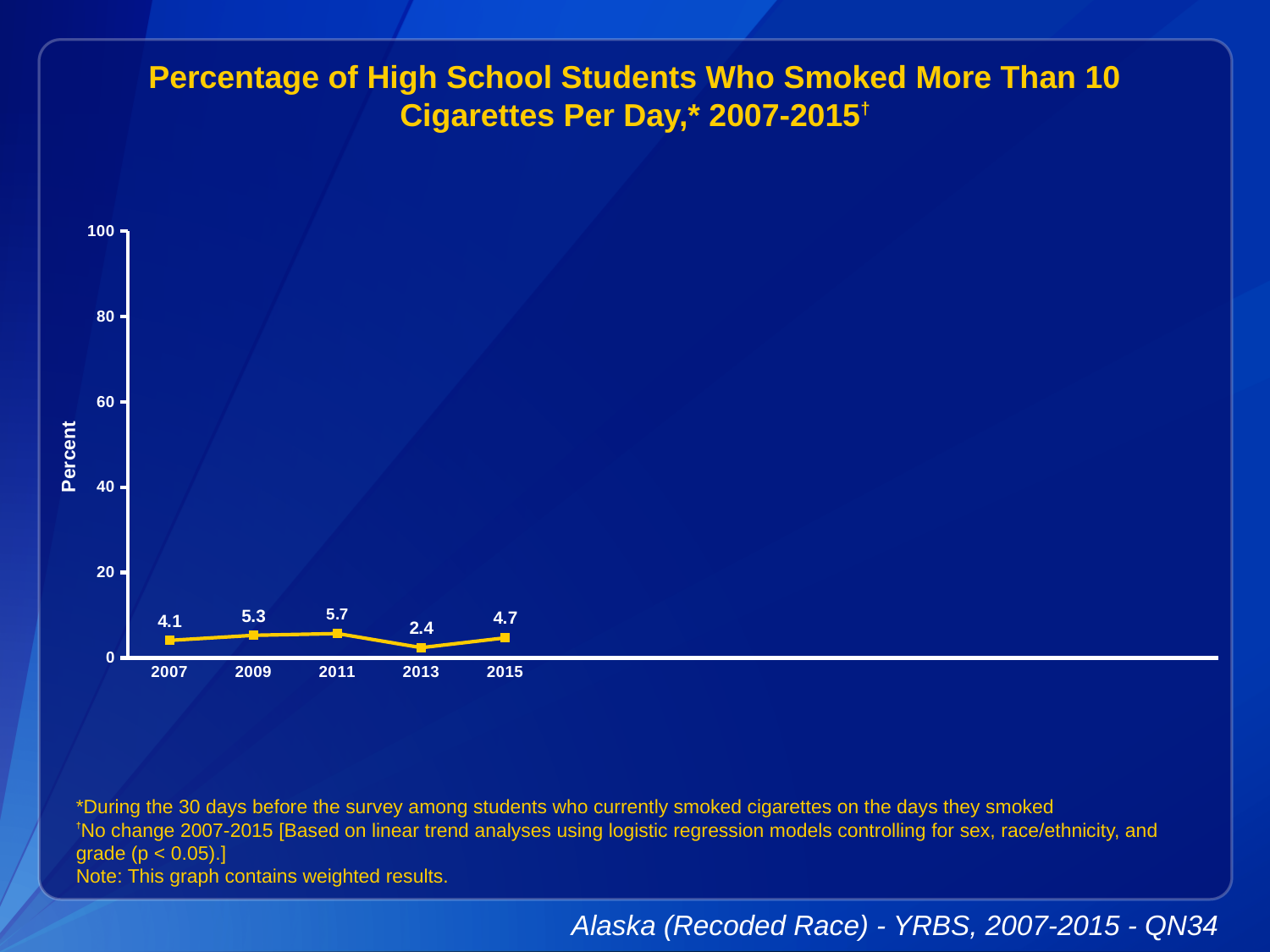
Which is larger, the value for 2009 or the value for 2015? 2009 What is the difference between the values for 2011 and 2013? 3.3 What is the label on the y axis? Percent Which year has the highest value? 2011 What is the value for 2007? 4.1 What is the value for 2015? 4.7 Is the value for 2011 greater or less than 20? less Which year has the lowest value? 2013 How many years are plotted on the chart? 5 Does the value rise or fall from 2007 to 2011? rise What is the value for 2013? 2.4 What kind of chart is shown? line chart